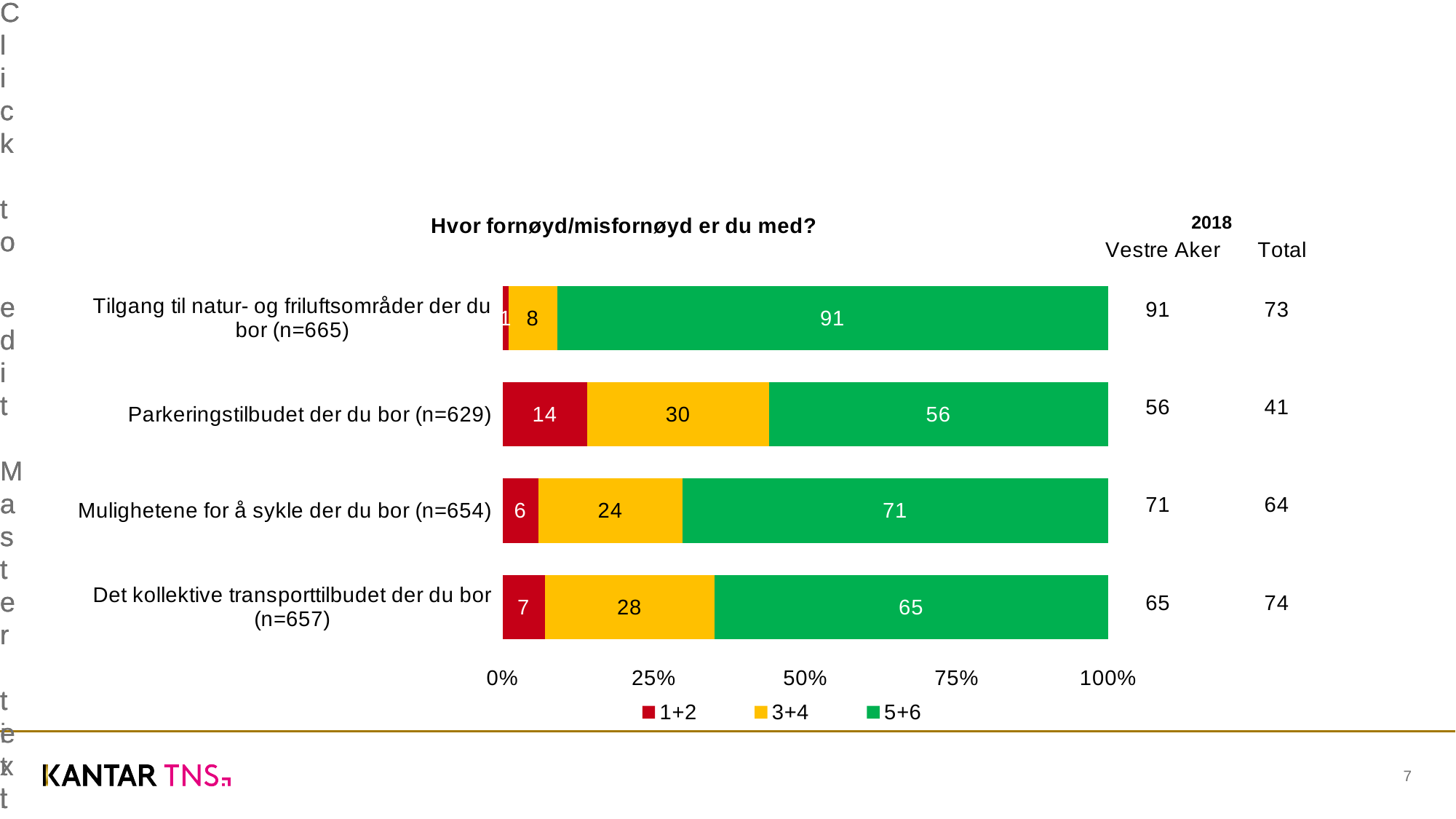
How many series does the legend list? 3 What is the value of the 1+2 series for "Mulighetene for å sykle der du bor (n=654)"? 6 Which category has the highest 5+6 value? Tilgang til natur- og friluftsområder der du bor (n=665) What is the value of the 5+6 series for "Parkeringstilbudet der du bor (n=629)"? 56 How many categories are shown in the chart? 4 What is the total of the stacked bar for "Parkeringstilbudet der du bor (n=629)"? 100 What is the difference between the 5+6 values for "Mulighetene for å sykle der du bor (n=654)" and "Det kollektive transporttilbudet der du bor (n=657)"? 6 Which category has the lowest 5+6 value? Parkeringstilbudet der du bor (n=629) What kind of chart is shown on the slide? Stacked bar chart What is the value of the 3+4 series for "Det kollektive transporttilbudet der du bor (n=657)"? 28 What is the title of the chart? Hvor fornøyd/misfornøyd er du med? Which is larger: the 3+4 value for "Parkeringstilbudet der du bor (n=629)" or the 3+4 value for "Mulighetene for å sykle der du bor (n=654)"? Parkeringstilbudet der du bor (n=629)